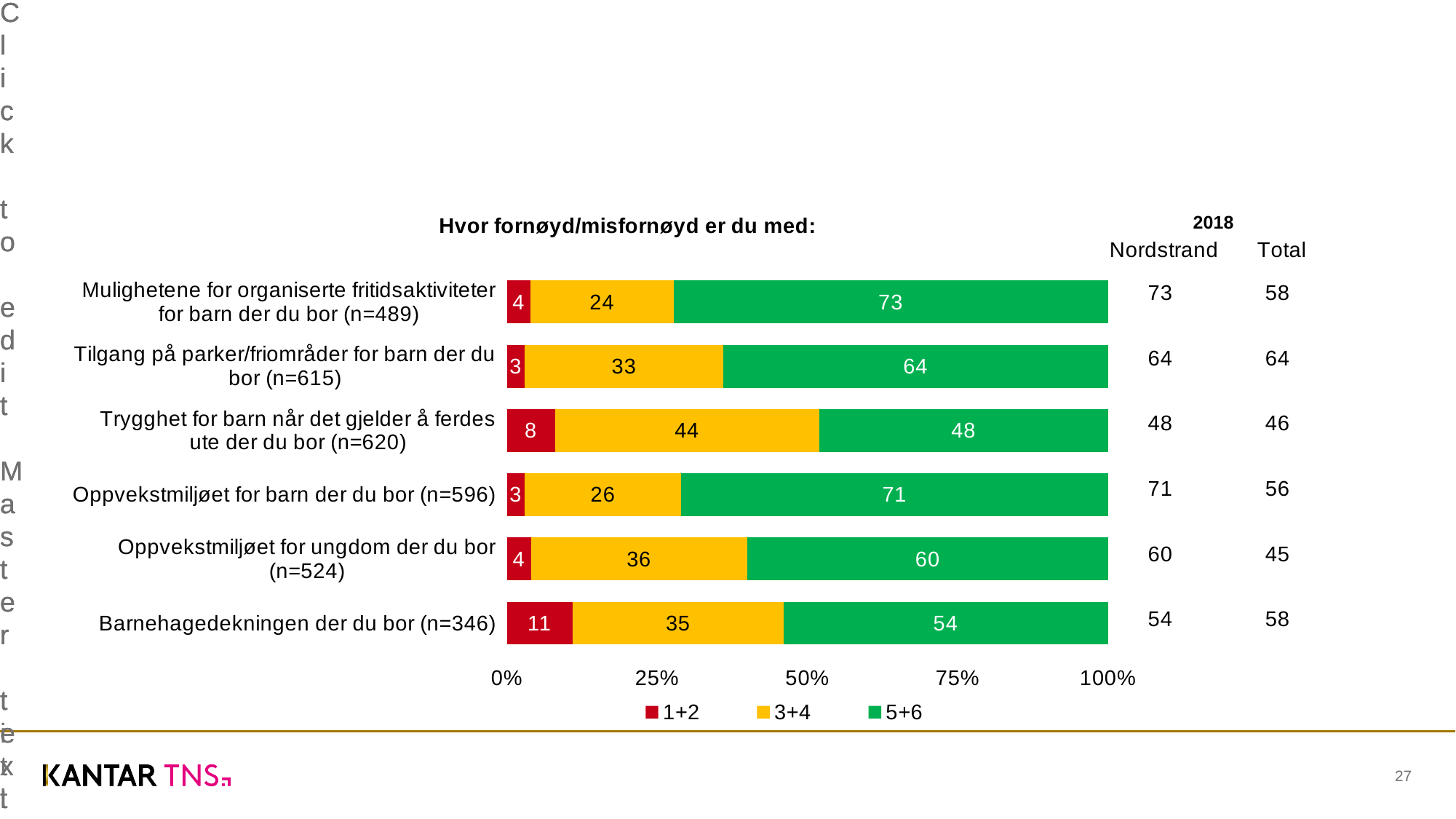
Which category has the lowest value for the 5+6 series? Trygghet for barn når det gjelder å ferdes ute der du bor (n=620) Which has the larger 3+4 value: "Trygghet for barn når det gjelder å ferdes ute der du bor (n=620)" or "Oppvekstmiljøet for ungdom der du bor (n=524)"? Trygghet for barn når det gjelder å ferdes ute der du bor (n=620) What is the value of the 1+2 segment for "Barnehagedekningen der du bor (n=346)"? 11 What kind of chart is shown on the slide? Stacked bar chart What is the difference between the 5+6 values for "Mulighetene for organiserte fritidsaktiviteter for barn der du bor (n=489)" and "Tilgang på parker/friområder for barn der du bor (n=615)"? 9 How many series does the legend list? 3 What is the value of the 3+4 segment for "Trygghet for barn når det gjelder å ferdes ute der du bor (n=620)"? 44 Which category has the highest value for the 5+6 series? Mulighetene for organiserte fritidsaktiviteter for barn der du bor (n=489) Which category has the highest value for the 1+2 series? Barnehagedekningen der du bor (n=346) What is the total of the stacked bar for "Trygghet for barn når det gjelder å ferdes ute der du bor (n=620)"? 100 How many categories are shown in the chart? 6 What is the value of the 5+6 segment for "Mulighetene for organiserte fritidsaktiviteter for barn der du bor (n=489)"? 73